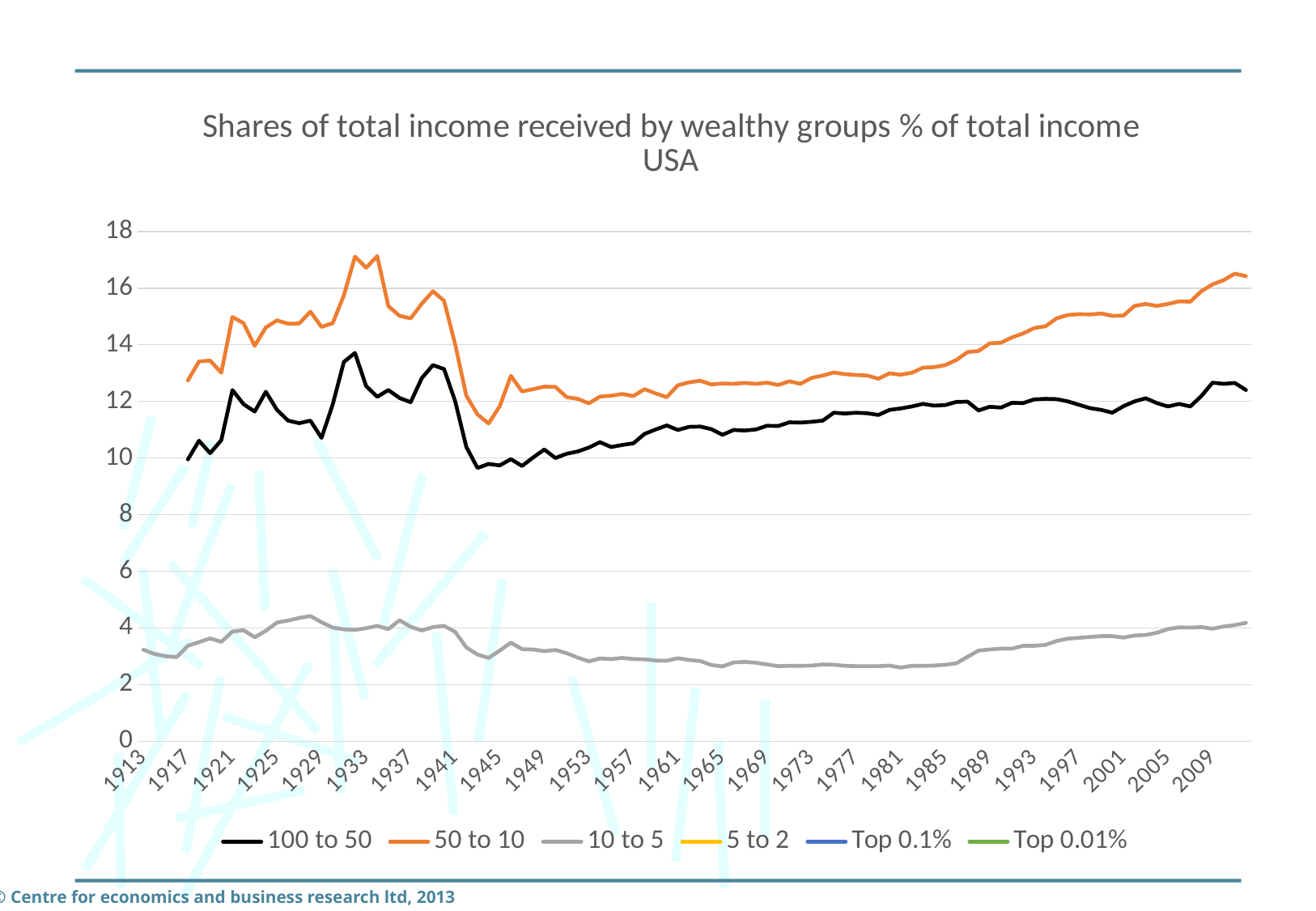
Which colour is used for the "50 to 10" series in the legend? orange Is the value for "100 to 50" in 2009 greater or less than 10? greater How many series does the legend list? 6 Is the value for "50 to 10" in 2009 greater or less than 14? greater In 1933, which series has the larger value, "50 to 10" or "100 to 50"? 50 to 10 Is the value for "10 to 5" in 1981 greater or less than 4? less Does the "50 to 10" series rise or fall between 1945 and 2009? rise What is the title of the chart? Shares of total income received by wealthy groups % of total income USA Which of the plotted series has the highest values across the chart? 50 to 10 What kind of chart is shown on the slide? line chart